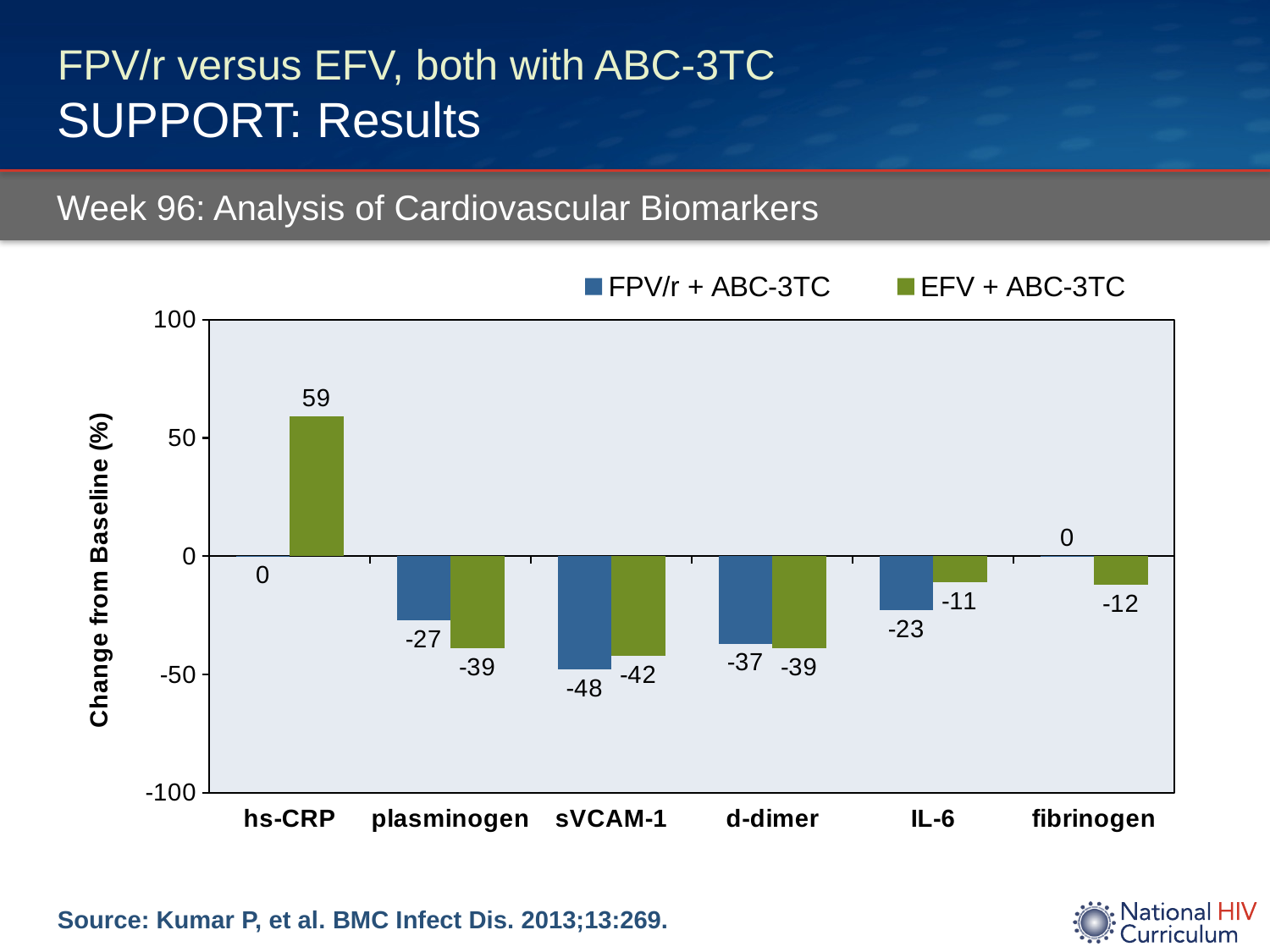
Which biomarker has the lowest value in the FPV/r + ABC-3TC group? sVCAM-1 Which biomarker has the highest value in the EFV + ABC-3TC group? hs-CRP What is the change from baseline for sVCAM-1 in the FPV/r + ABC-3TC group? -48 How many series does the legend list? 2 What is the label of the y axis? Change from Baseline (%) What is the difference between the EFV + ABC-3TC and FPV/r + ABC-3TC values for plasminogen? 12 What is the change from baseline for IL-6 in the EFV + ABC-3TC group? -11 How many biomarkers are shown on the x axis? 6 What is the change from baseline for hs-CRP in the EFV + ABC-3TC group? 59 What kind of chart is shown on the slide? Bar chart For IL-6, which group has the larger decrease from baseline, FPV/r + ABC-3TC or EFV + ABC-3TC? FPV/r + ABC-3TC What is the change from baseline for fibrinogen in the FPV/r + ABC-3TC group? 0